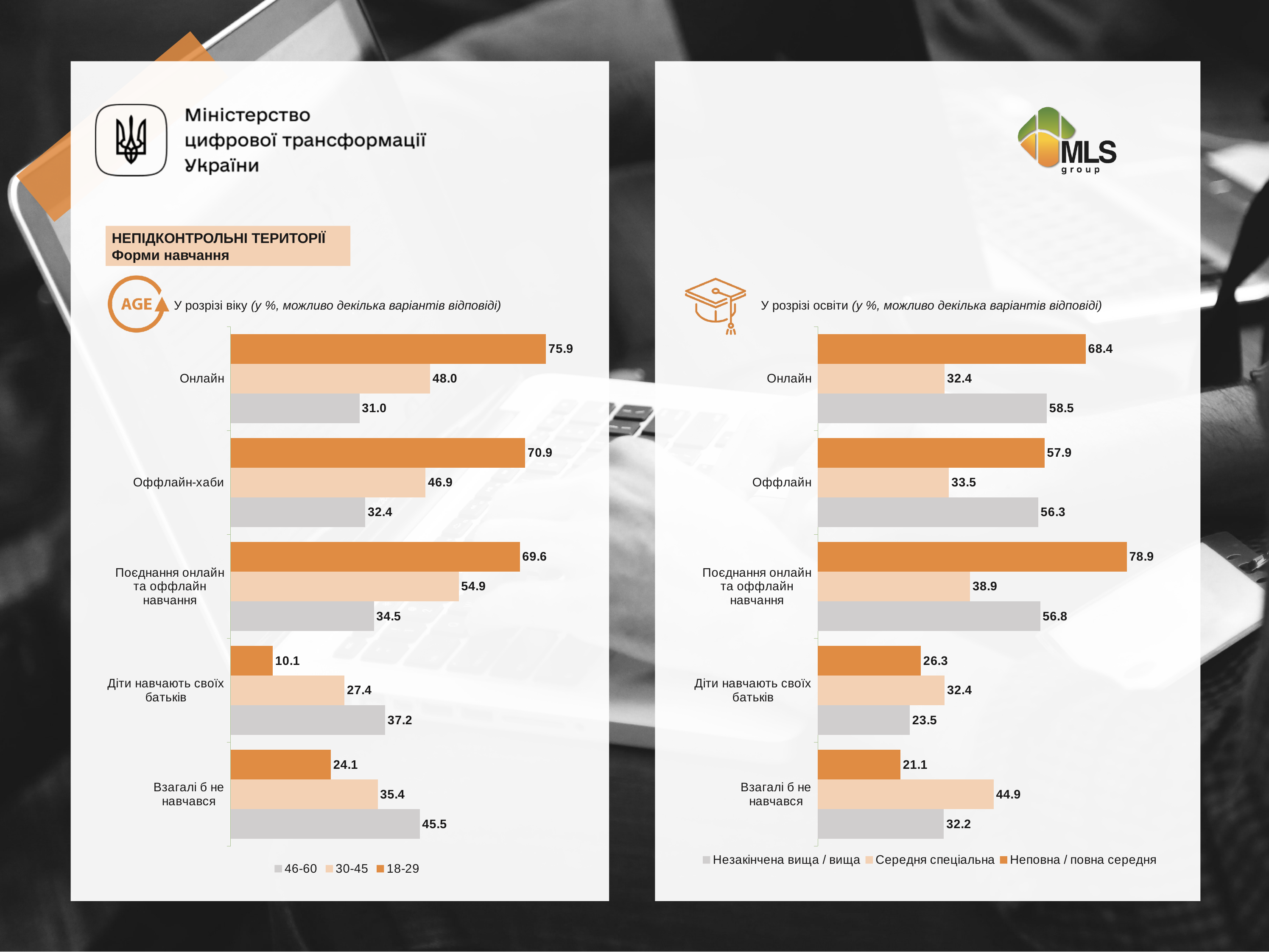
How many categories are shown in the right chart (У розрізі освіти)? 5 What type of chart is the left chart (У розрізі віку)? Bar chart In the right chart (У розрізі освіти), what is the value for Взагалі б не навчався in the Середня спеціальна series? 44.9 In the left chart (У розрізі віку), how many series does the legend list? 3 In the left chart (У розрізі віку), which is larger for Взагалі б не навчався: the 30-45 value or the 46-60 value? 46-60 In the left chart (У розрізі віку), what is the value for Діти навчають своїх батьків in the 46-60 series? 37.2 In the left chart (У розрізі віку), which category has the lowest value in the 18-29 series? Діти навчають своїх батьків In the right chart (У розрізі освіти), which category has the highest value in the Незакінчена вища / вища series? Онлайн In the left chart (У розрізі віку), what is the difference between the 18-29 and 46-60 values for Онлайн? 44.9 In the left chart (У розрізі віку), what is the value for Онлайн in the 18-29 series? 75.9 In the right chart (У розрізі освіти), what is the difference between the Неповна / повна середня and Середня спеціальна values for Онлайн? 36.0 In the right chart (У розрізі освіти), what is the value for Поєднання онлайн та оффлайн навчання in the Неповна / повна середня series? 78.9